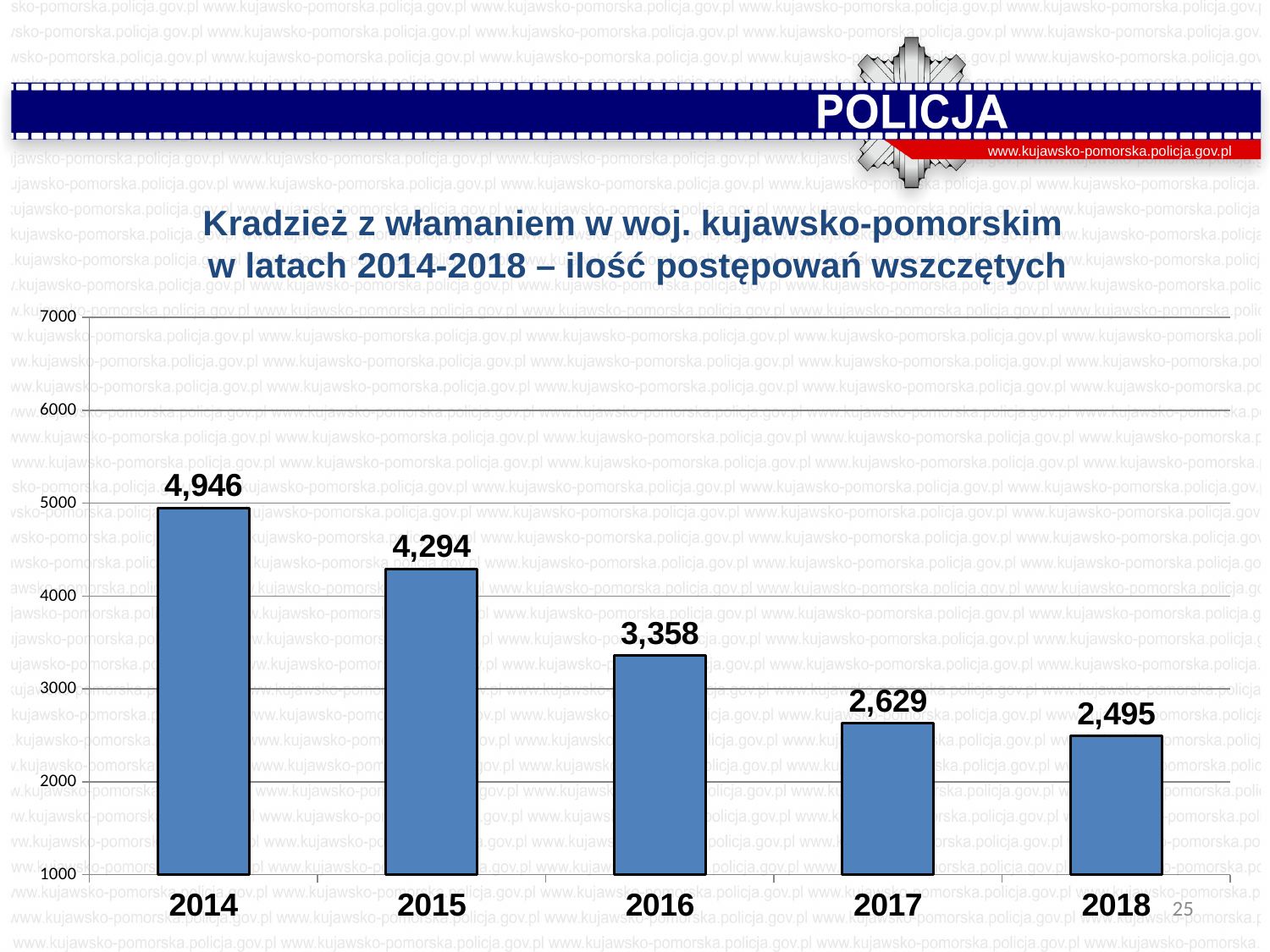
What is the difference between the values for 2017 and 2018? 134 Which is larger, the value for 2016 or the value for 2017? 2016 How many years are shown on the chart? 5 Which year has the highest value? 2014 Do the values rise or fall from 2014 to 2018? fall Is the value for 2015 greater or less than 4000? greater What value is shown for 2018? 2,495 What kind of chart is shown on the slide? bar chart What is the difference between the values for 2014 and 2015? 652 What value is shown for 2016? 3,358 Which year has the lowest value? 2018 What was the number of proceedings initiated in 2014? 4,946